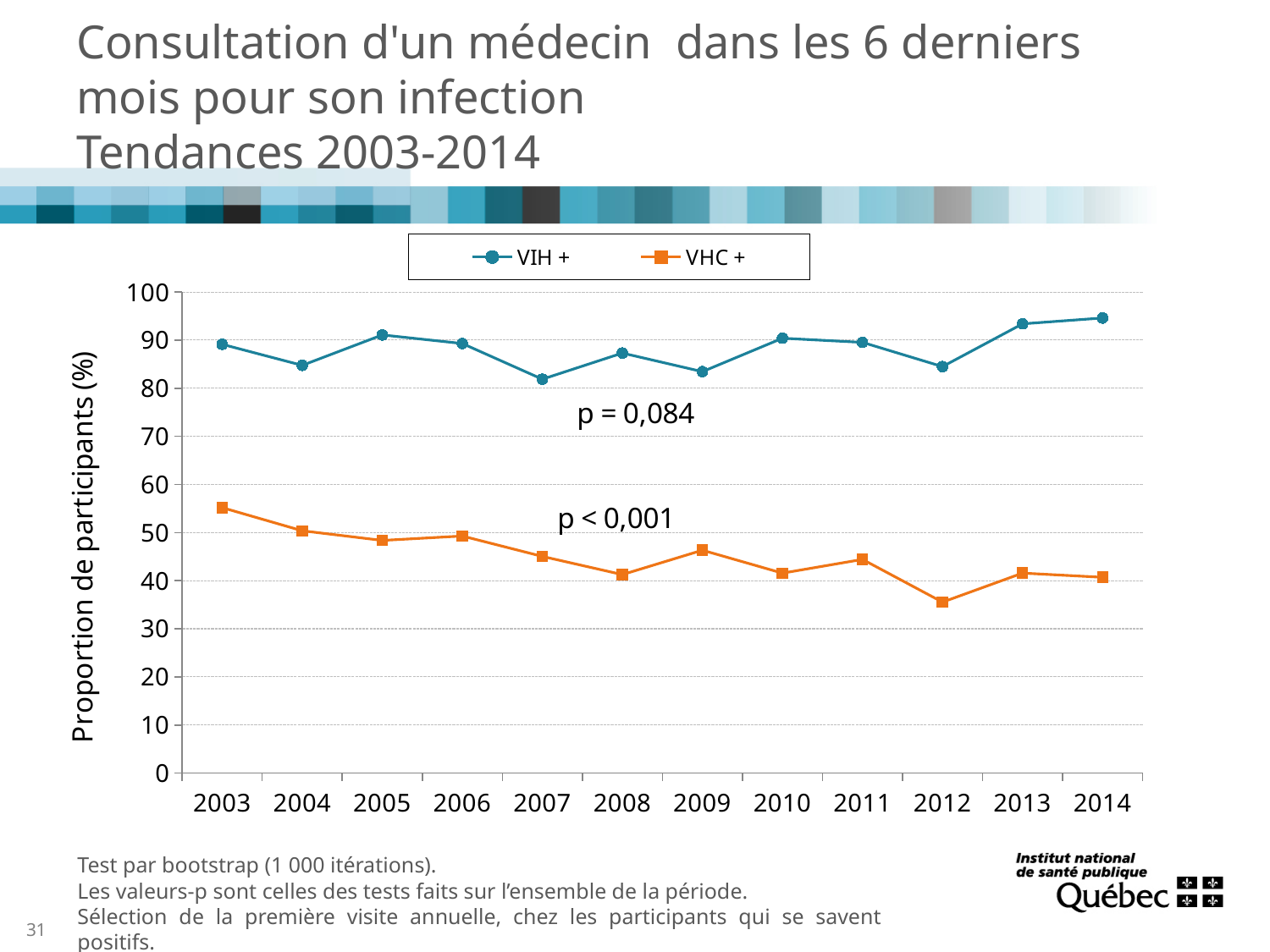
Is the value for VHC + in 2003 greater or less than 50? greater What kind of chart is shown on the slide? line chart In which year is the VHC + series at its highest? 2003 What p-value is printed next to the VHC + line? p < 0,001 Is the value for VHC + in 2012 greater or less than 40? less How many series does the legend list? 2 Which series has the highest value in 2003? VIH + Is the value for VIH + in 2014 greater or less than 90? greater How many years are plotted along the x axis? 12 In which year is the VHC + series at its lowest? 2012 What is the label of the y axis? Proportion de participants (%) Does the VHC + series generally rise or fall from 2003 to 2014? fall